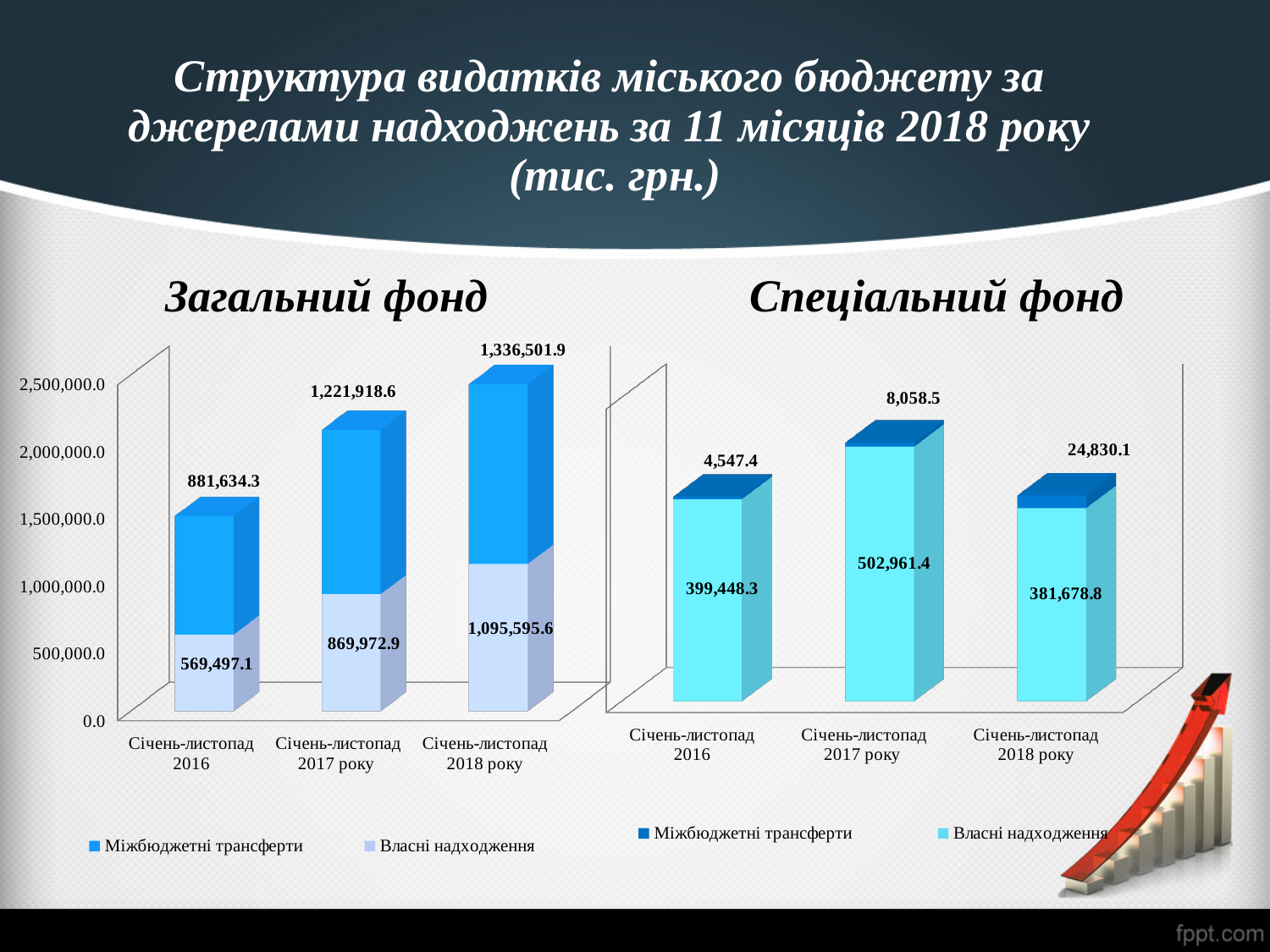
In the Спеціальний фонд chart, which period has the lowest value of Міжбюджетні трансферти? Січень-листопад 2016 In the Загальний фонд chart, which period has the highest value of Власні надходження? Січень-листопад 2018 року In the Спеціальний фонд chart, what is the total of the stacked bar for Січень-листопад 2017 року? 511,019.9 In the Спеціальний фонд chart, what is the value of Власні надходження for Січень-листопад 2017 року? 502,961.4 In the Спеціальний фонд chart, what is the value of Міжбюджетні трансферти for Січень-листопад 2018 року? 24,830.1 In the Загальний фонд chart, what is the value of Власні надходження for Січень-листопад 2016? 569,497.1 In the Спеціальний фонд chart, is Власні надходження larger for Січень-листопад 2017 року or Січень-листопад 2018 року? Січень-листопад 2017 року How many series does the legend of the Загальний фонд chart list? 2 What kind of chart is the Спеціальний фонд chart? Stacked bar chart In the Загальний фонд chart, what is the difference between Міжбюджетні трансферти for Січень-листопад 2018 року and Січень-листопад 2017 року? 114,583.3 In the Загальний фонд chart, what is the total of the stacked bar for Січень-листопад 2016? 1,451,131.4 In the Загальний фонд chart, what is the value of Міжбюджетні трансферти for Січень-листопад 2018 року? 1,336,501.9